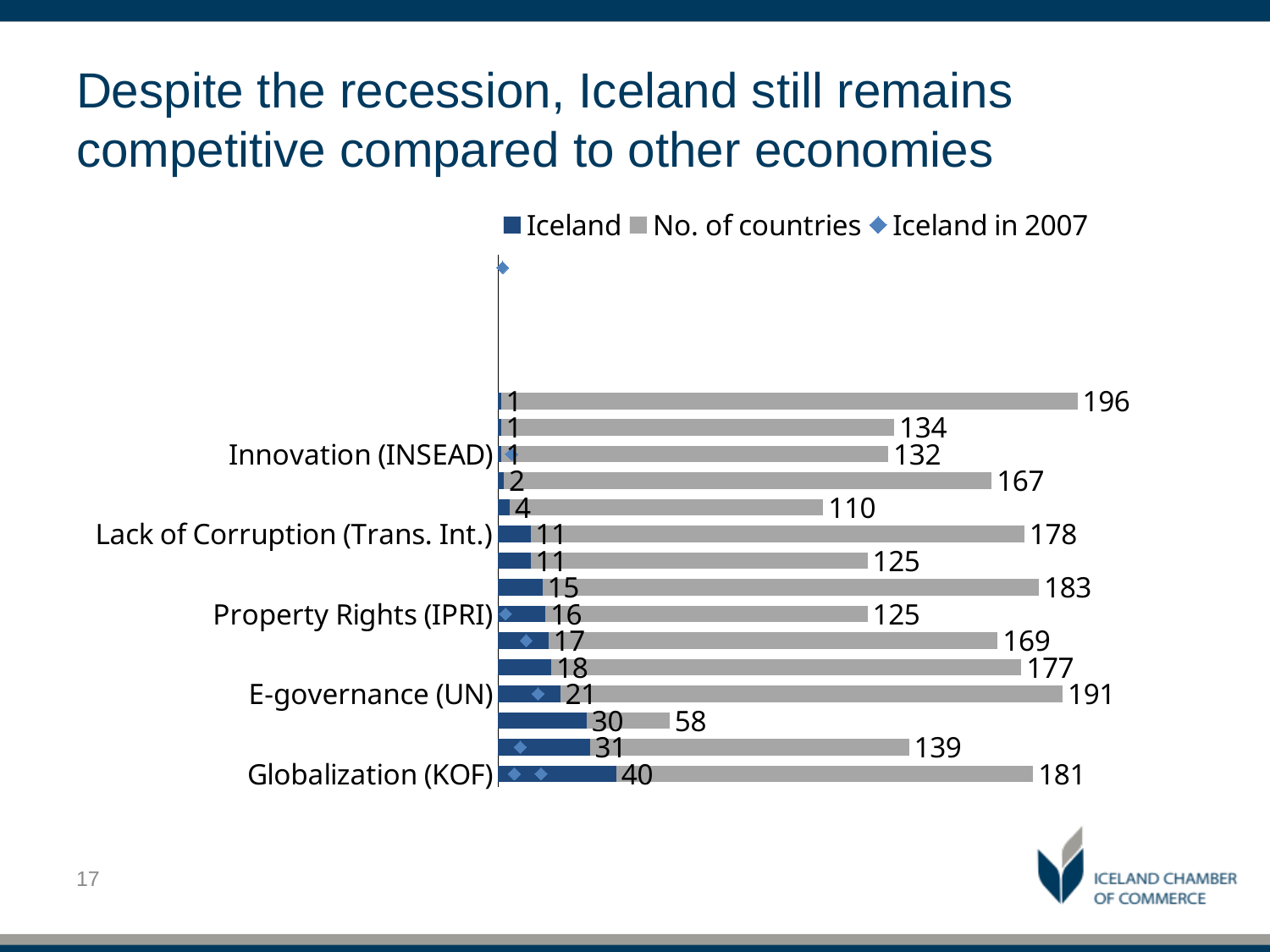
What kind of chart is shown on the slide? bar chart What is the No. of countries value for Property Rights (IPRI)? 125 What is the Iceland value for Globalization (KOF)? 40 Among the labelled categories, which has the highest Iceland value? Globalization (KOF) What is the Iceland value for Lack of Corruption (Trans. Int.)? 11 What is the lowest No. of countries value shown on the chart? 58 Which is larger, the No. of countries value for E-governance (UN) or for Property Rights (IPRI)? E-governance (UN) How many series does the legend list? 3 What is the difference between the No. of countries value and the Iceland value for Globalization (KOF)? 141 What is the Iceland value for Innovation (INSEAD)? 1 What is the highest No. of countries value shown on the chart? 196 What is the No. of countries value for E-governance (UN)? 191